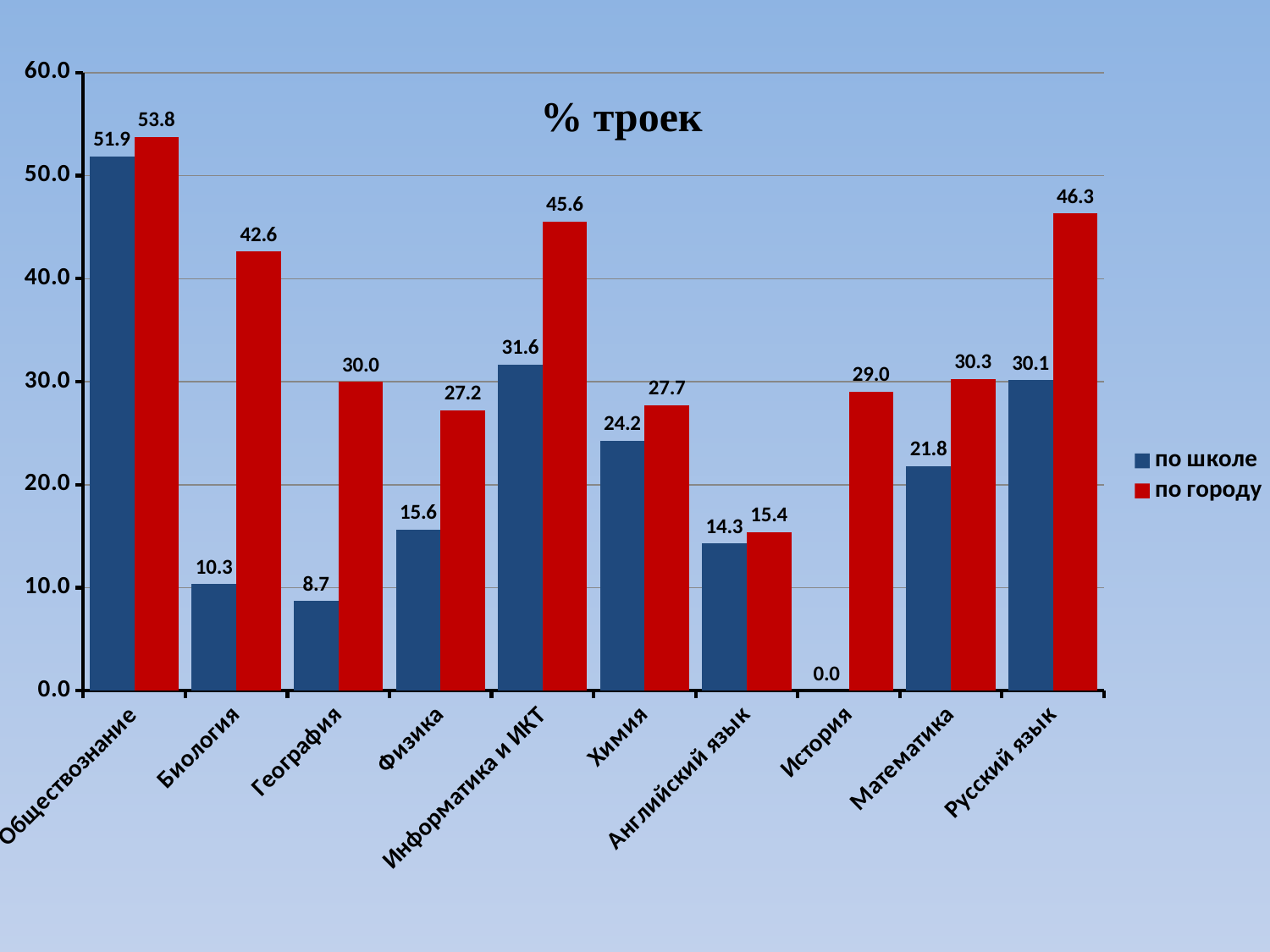
What is the value for Информатика и ИКТ in the по школе series? 31.6 Is the по городу value for Физика greater or less than 30.0? less What is the difference between the по городу and по школе values for Биология? 32.3 Which category has the highest value in the по школе series? Обществознание What is the title of the chart? % троек What kind of chart is shown on the slide? bar chart How many series does the legend list? 2 What is the value for Биология in the по городу series? 42.6 Which category has the lowest value in the по городу series? Английский язык Which is larger for Русский язык: the по школе value or the по городу value? по городу How many categories are shown on the x axis? 10 What is the value for История in the по школе series? 0.0